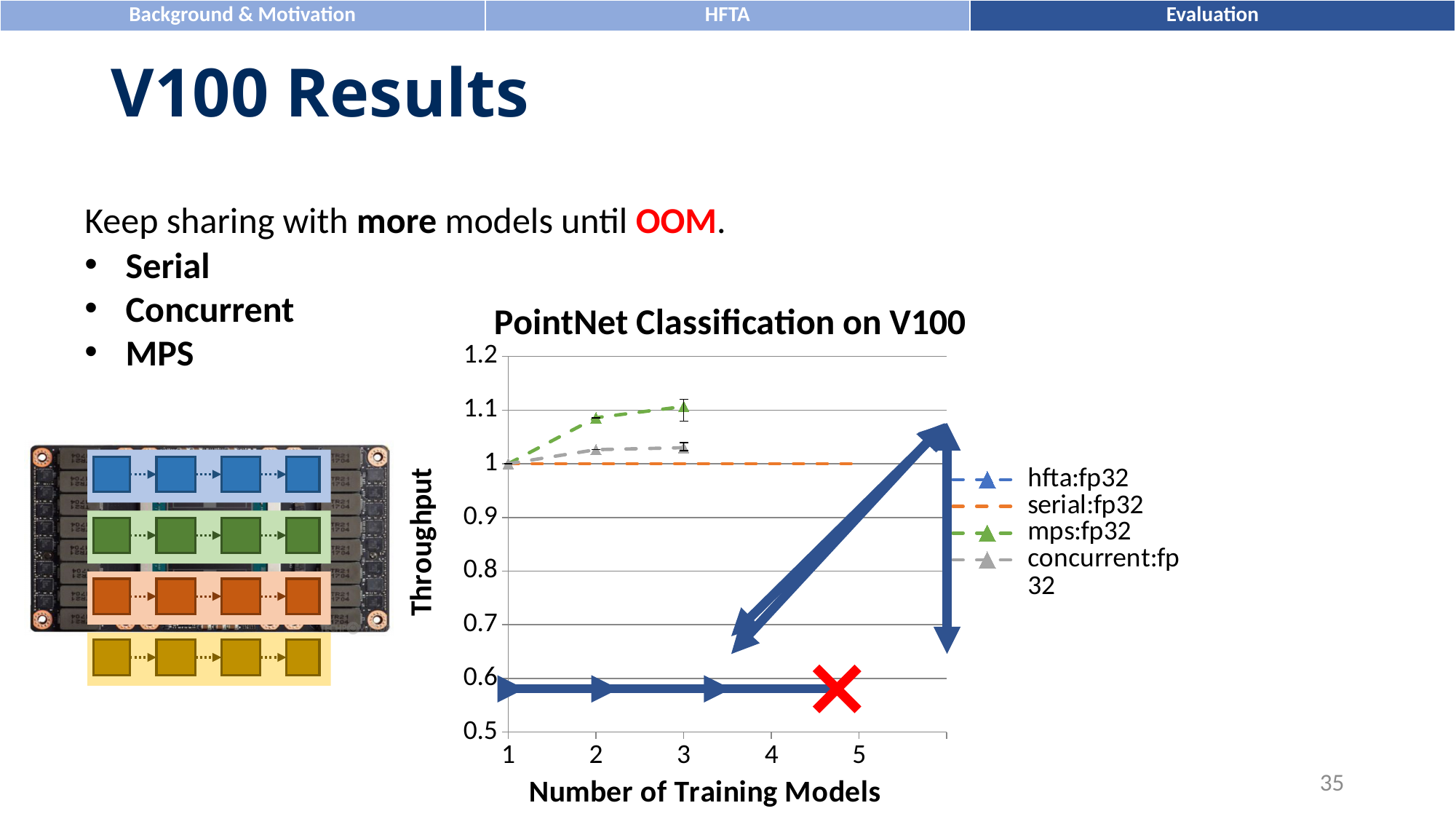
Does the throughput of serial:fp32 rise, fall, or stay flat as the number of training models increases from 1 to 5? stay flat What is the title of the chart? PointNet Classification on V100 What is the throughput of serial:fp32 at 1 training model? 1 How many series does the chart legend list? 4 What kind of chart is shown on the slide? line chart Is the throughput of concurrent:fp32 at 3 training models greater or less than 1.1? less Does the throughput of mps:fp32 rise or fall as the number of training models increases from 1 to 3? rise Is the throughput of mps:fp32 at 2 training models greater or less than 1.1? less At 3 training models, which series has the higher throughput, mps:fp32 or concurrent:fp32? mps:fp32 What is the label of the chart's y axis? Throughput How many values for the number of training models are marked on the x axis? 5 Is the throughput of mps:fp32 at 3 training models greater or less than 1? greater